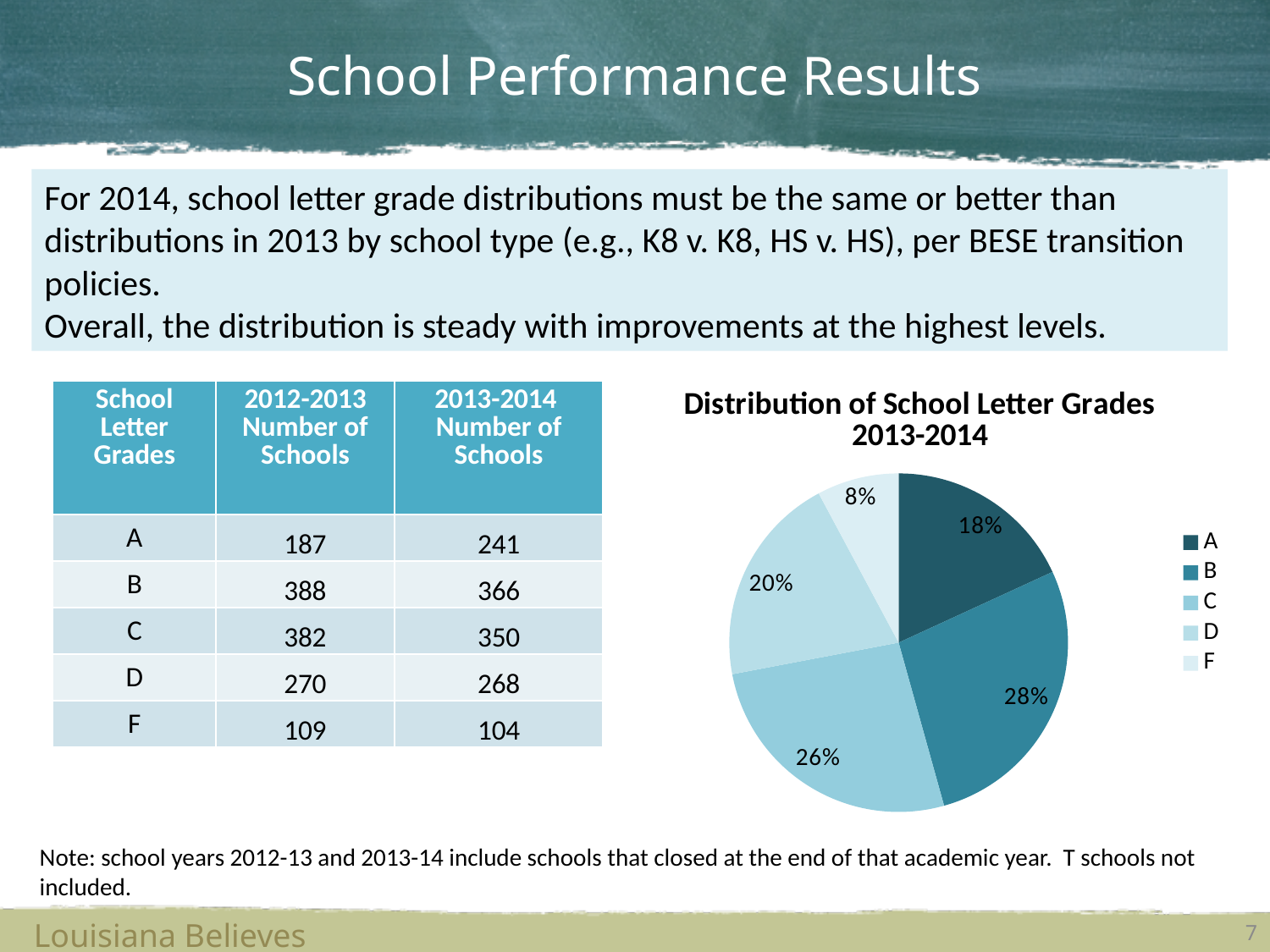
How many entries does the pie chart's legend list? 5 Which letter grade has the smallest slice of the pie? F How many slices does the pie chart have? 5 What type of chart is shown on the slide? pie chart What share of the pie does letter grade D represent? 20% What share of the pie does letter grade C represent? 26% What is the title of the pie chart? Distribution of School Letter Grades 2013-2014 What share of the pie does letter grade B represent? 28% What is the difference in percentage points between the B slice and the A slice? 10 Which letter grade has the largest slice of the pie? B